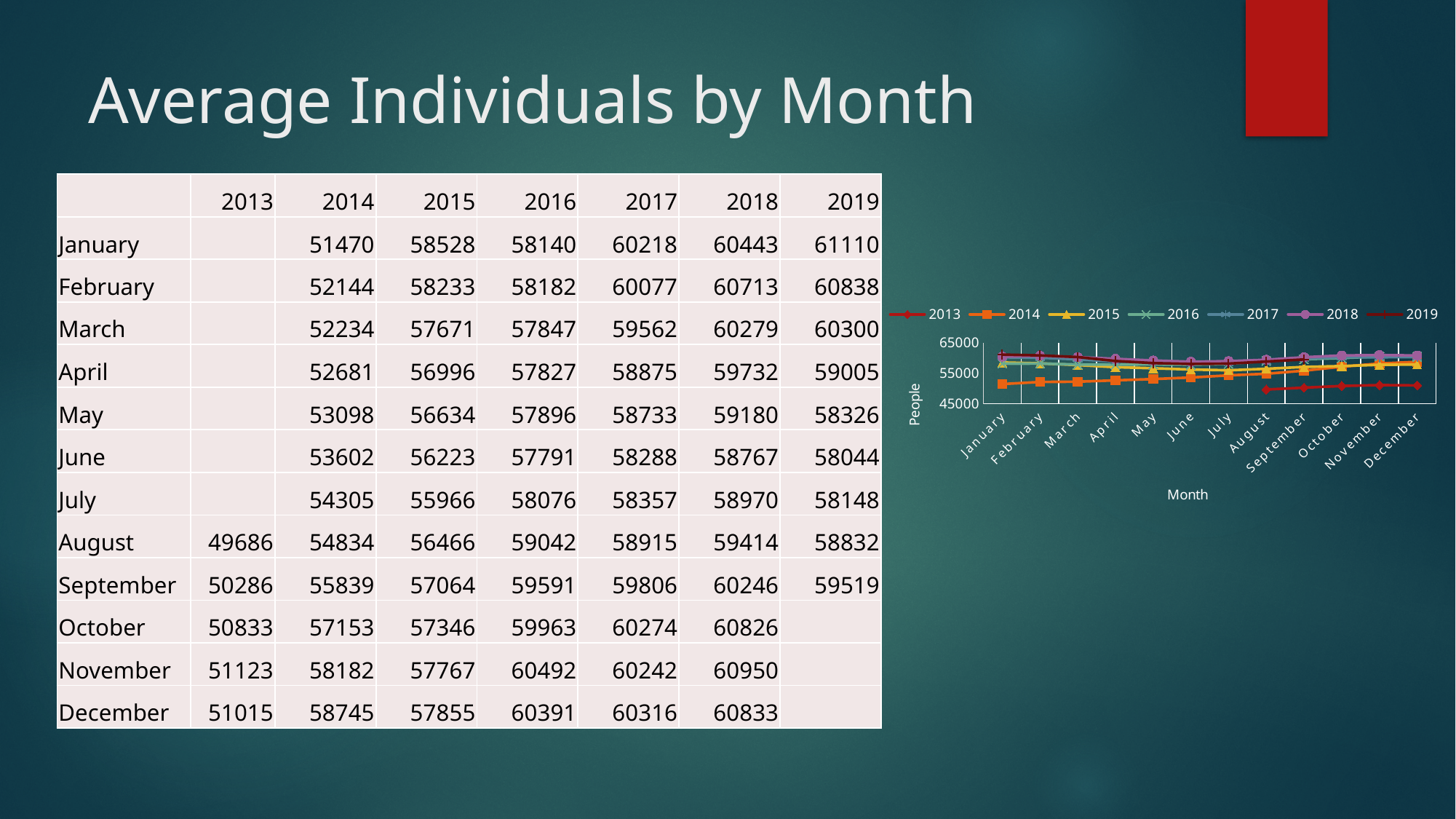
What is the average number of individuals for January 2019? 61110 Is the value for 2018 in November greater or less than 55000? greater What kind of chart is shown on the right of the slide? line chart In June, which series has the larger value, 2014 or 2018? 2018 How many months are shown along the x axis of the chart? 12 Does the 2014 series rise or fall from January to December? rise What is the value for August in the 2013 series? 49686 Is the value for 2014 in January greater or less than 55000? less Which month has the lowest value in the 2013 series? August What is the difference between the December values for 2018 and 2013? 9818 How many series does the chart's legend list? 7 What is the title of the chart's vertical axis? People